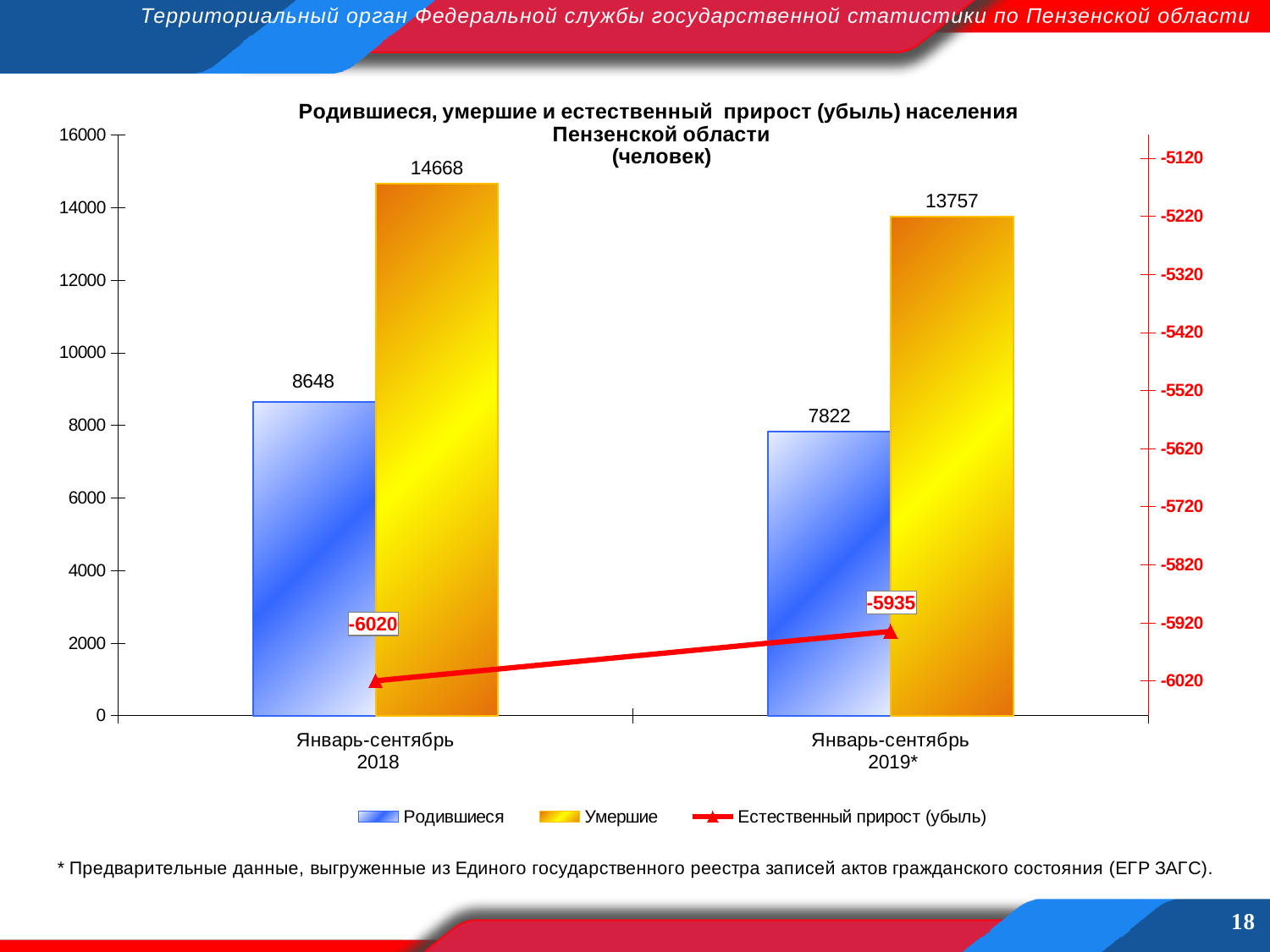
Is the value for Родившиеся in Январь-сентябрь 2019* greater or less than 8000? less What colour are the bars for Умершие? Yellow/orange What is the value for Родившиеся in Январь-сентябрь 2018? 8648 What is the value of Естественный прирост (убыль) for Январь-сентябрь 2018? -6020 What is the value of Естественный прирост (убыль) for Январь-сентябрь 2019*? -5935 By how much did Родившиеся decrease from Январь-сентябрь 2018 to Январь-сентябрь 2019*? 826 Does the Естественный прирост (убыль) line rise or fall from 2018 to 2019*? rise What is the value for Умершие in Январь-сентябрь 2019*? 13757 How many series does the legend list? 3 Which period has the lower value for Родившиеся? Январь-сентябрь 2019* What is the difference between Умершие and Родившиеся in Январь-сентябрь 2018? 6020 Which period has the higher value for Умершие? Январь-сентябрь 2018